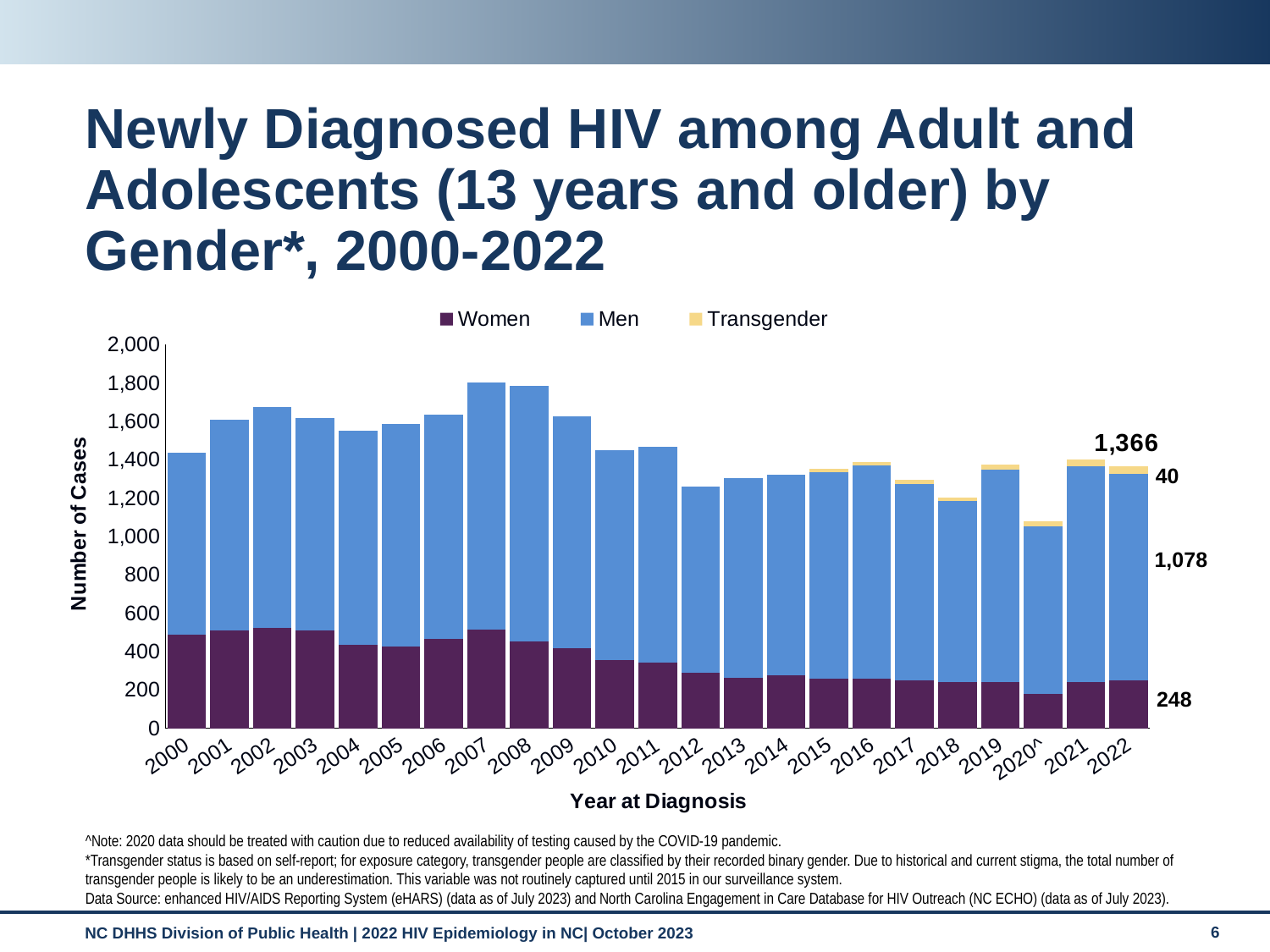
What is the number of newly diagnosed cases among Women in 2022? 248 Which year has a larger total number of cases, 2002 or 2012? 2002 What is the number of newly diagnosed cases among Transgender people in 2022? 40 What is the number of newly diagnosed cases among Men in 2022? 1,078 How many series does the legend list? 3 What is the total number of newly diagnosed cases in 2022? 1,366 What is the difference between the Men and Women values in 2022? 830 What kind of chart is shown on the slide? Stacked bar chart Is the total number of cases in 2007 greater or less than 1,600? greater What is the title of the y axis? Number of Cases Which year has the lowest total number of cases? 2020 How many years are shown along the x axis? 23